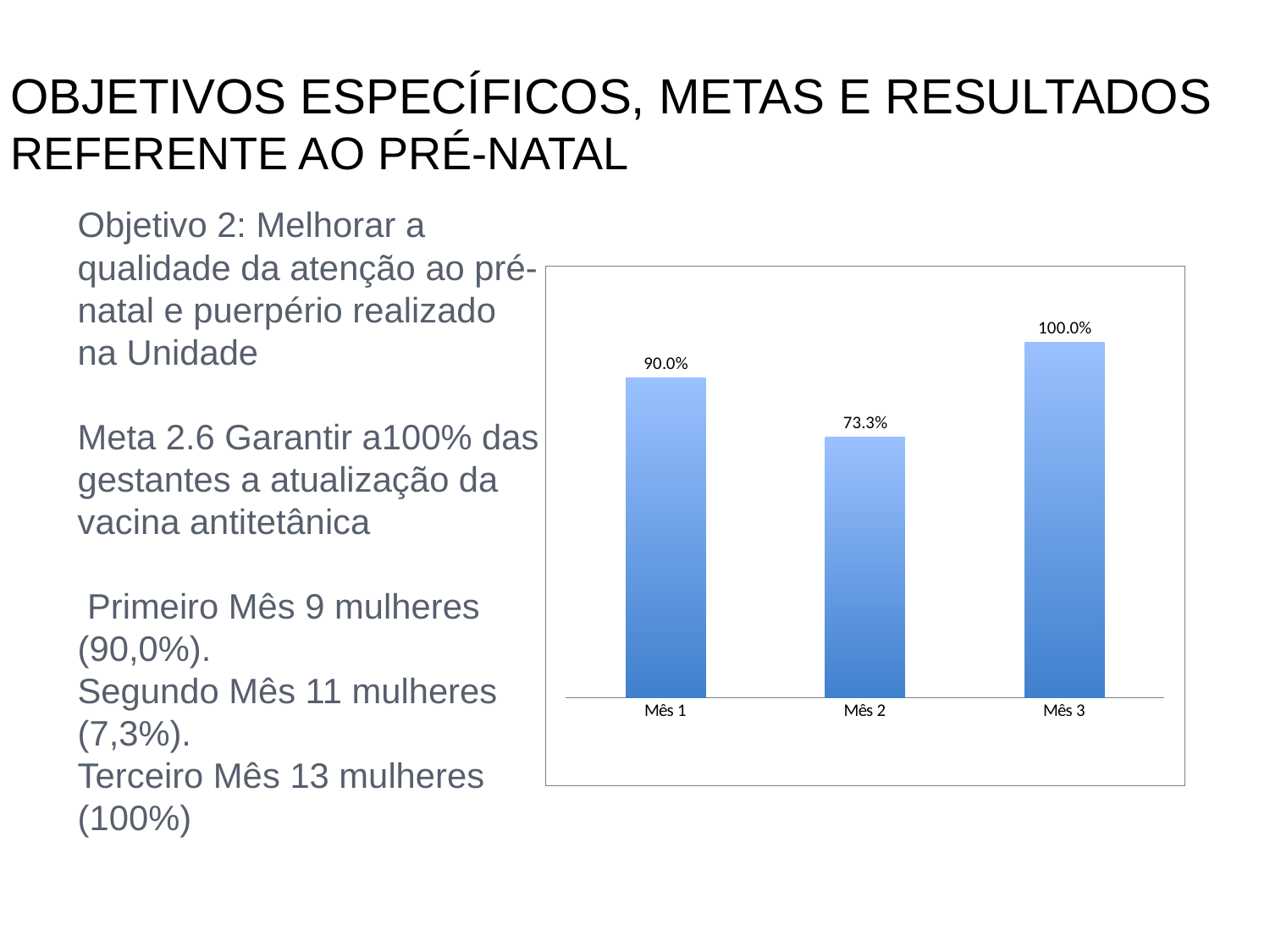
How many categories are shown on the x axis of the chart? 3 Does the value fall or rise from Mês 2 to Mês 3? Rise What kind of chart is shown on the slide? Bar chart Which is larger, the value for Mês 1 or the value for Mês 2? Mês 1 What is the value for Mês 1? 90.0% Which month has the lowest value? Mês 2 What is the difference between the values for Mês 3 and Mês 1? 10.0% Which month has the highest value? Mês 3 What is the value for Mês 2? 73.3% What is the value for Mês 3? 100.0% What colour are the bars in the chart? Blue What is the difference between the values for Mês 1 and Mês 2? 16.7%